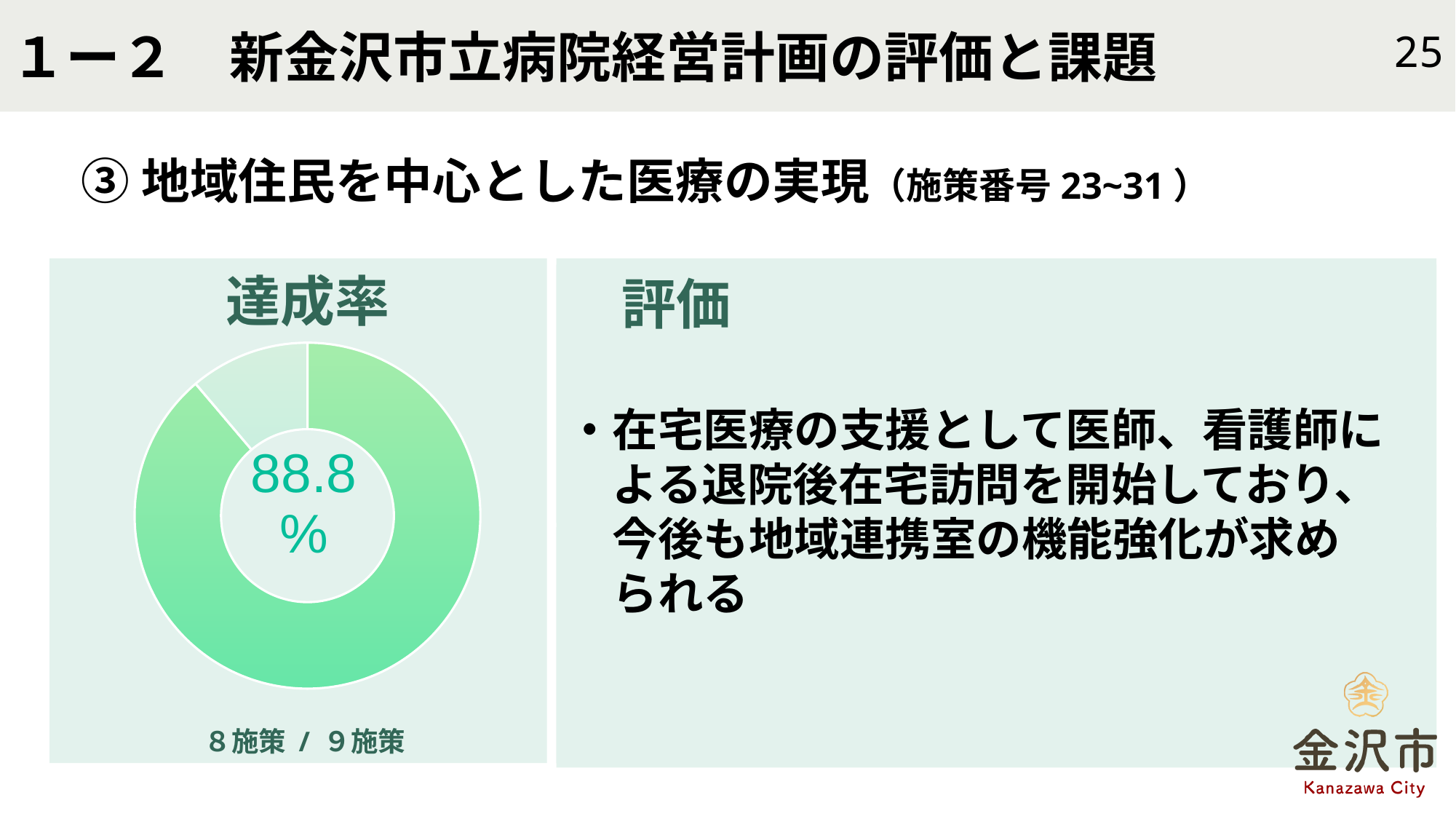
What value is printed in the center of the 達成率 chart? 88.8% What text is printed below the 達成率 donut chart? 8施策 / 9施策 Is the achievement rate shown in the 達成率 chart greater or less than 90%? less In the 達成率 chart, which slice is larger, the darker green one or the lighter green one? the darker green one Is the achievement rate shown in the 達成率 chart greater or less than 50%? greater What share of the 達成率 donut does the larger (darker green) slice represent? 88.8% What is the title above the donut chart? 達成率 According to the caption below the 達成率 chart, how many measures are there in total? 9施策 According to the caption below the 達成率 chart, how many measures were achieved? 8施策 What kind of chart is shown under the heading 達成率? pie chart (donut) How many slices does the 達成率 donut chart have? 2